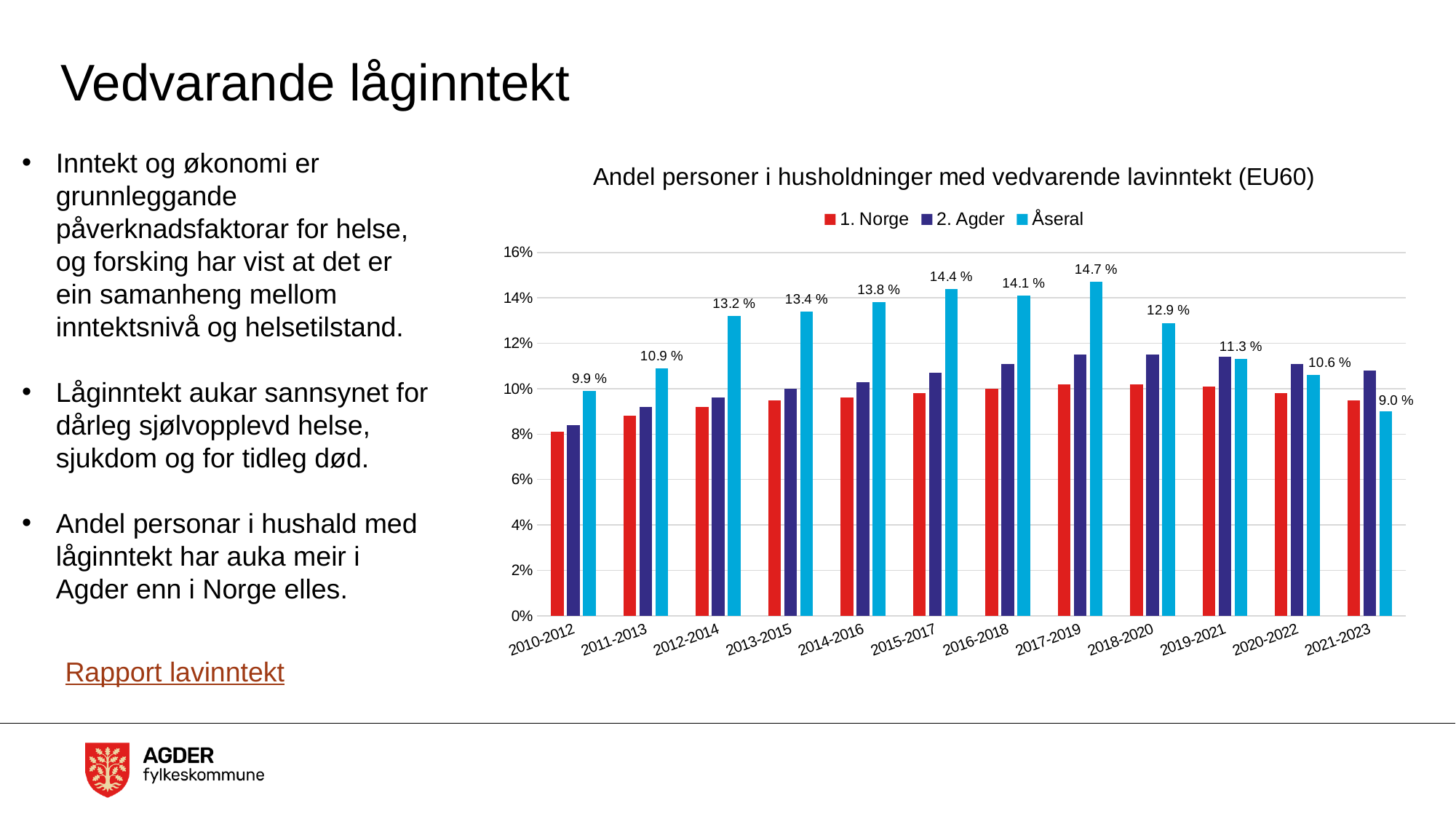
What is the difference between the Åseral values for 2017-2019 and 2021-2023? 5.7 percentage points Is the value for 2. Agder in 2019-2021 greater or less than 10%? greater How many series does the legend list? 3 How many periods are shown on the x axis? 12 In which period is the Åseral value lowest? 2021-2023 In which period is the Åseral value highest? 2017-2019 Is the value for 1. Norge in 2010-2012 greater or less than 10%? less What is the value for Åseral in 2018-2020? 12.9 % Do the Åseral values rise or fall from 2017-2019 to 2021-2023? fall Which is larger for Åseral: the value for 2012-2014 or for 2013-2015? 2013-2015 What is the value for Åseral in 2017-2019? 14.7 % What is the value for Åseral in 2010-2012? 9.9 %